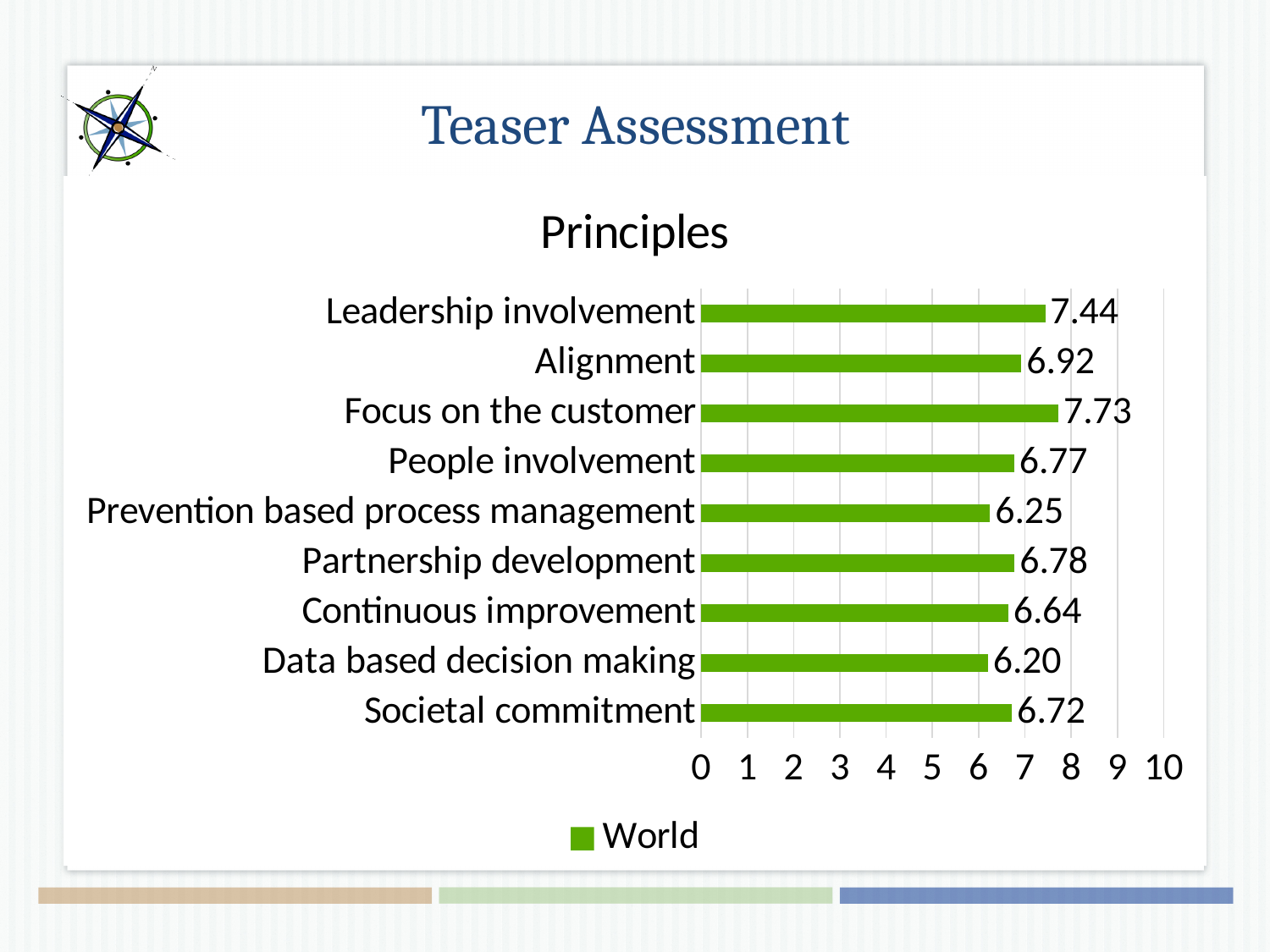
What is the value for Prevention based process management? 6.25 What kind of chart is shown? bar chart How many series does the legend list? 1 What is the title of the chart? Principles Which principle has the highest value? Focus on the customer Which is larger, the value for Continuous improvement or the value for Societal commitment? Societal commitment How many principles are shown in the chart? 9 What is the value for Data based decision making? 6.20 Is the value for People involvement greater or less than 6? greater What is the difference between the values for Leadership involvement and Alignment? 0.52 What is the value for Focus on the customer? 7.73 Which principle has the lowest value? Data based decision making